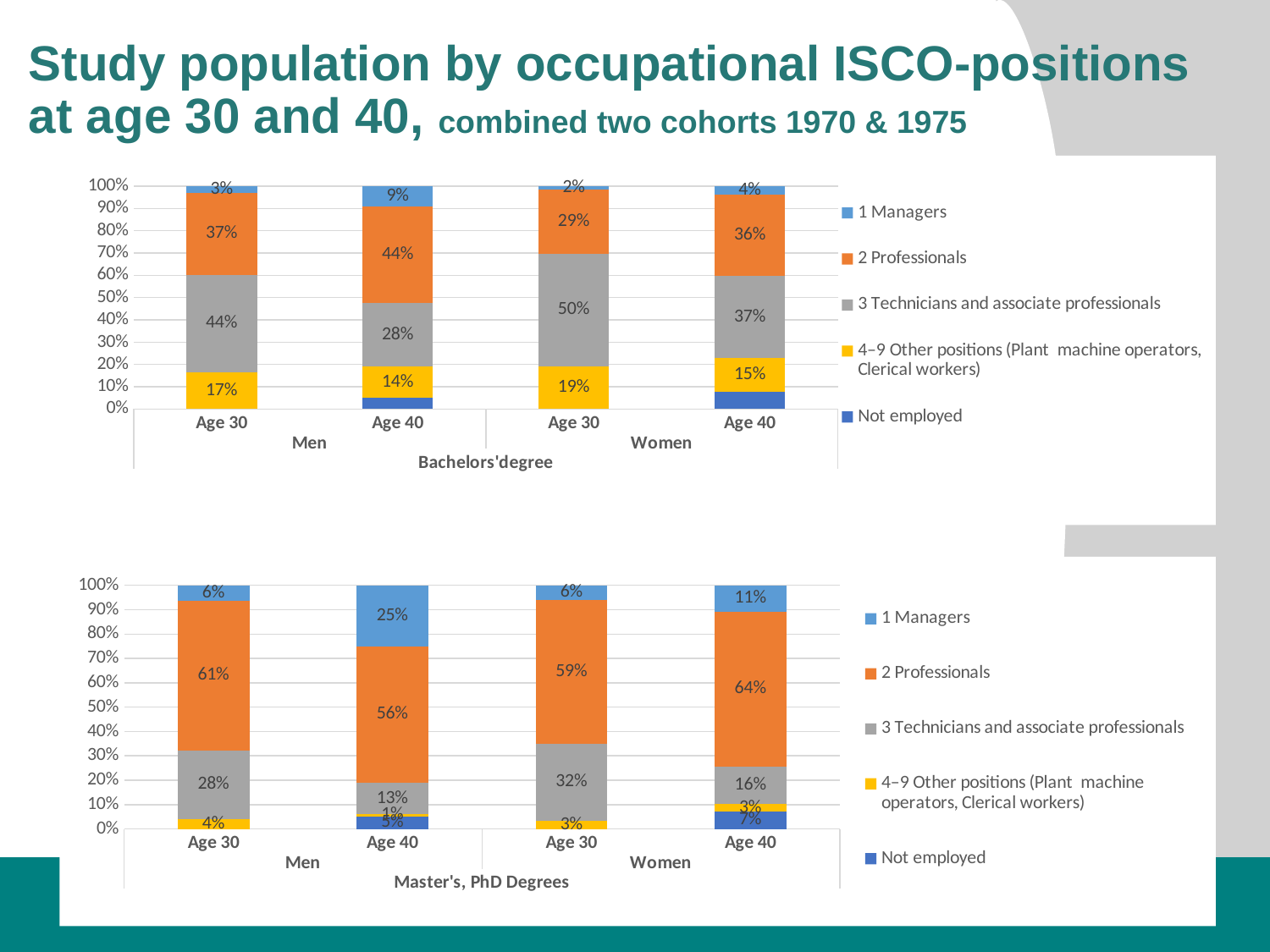
In the Bachelors'degree chart, what percentage of women at age 30 are Professionals? 29% In the Master's, PhD Degrees chart, what percentage of men at age 40 are Managers? 25% What type of chart is the Bachelors'degree chart? Stacked bar chart In the Bachelors'degree chart, which of the four bars has the highest share of Technicians and associate professionals? Women Age 30 How many bars are plotted in the Master's, PhD Degrees chart? 4 In the Bachelors'degree chart, what is the difference between the Professionals share for men at age 40 and men at age 30? 7% In the Master's, PhD Degrees chart, what percentage of women at age 40 are Professionals? 64% In the Master's, PhD Degrees chart, is the Professionals share for men at age 30 larger or smaller than for women at age 30? larger In the Master's, PhD Degrees chart, which bar has the lowest share of Technicians and associate professionals? Men Age 40 In the Bachelors'degree chart, what percentage of men at age 40 are Managers? 9% How many series does the legend of the Bachelors'degree chart list? 5 In the Bachelors'degree chart, what percentage of men at age 30 are in Technicians and associate professionals positions? 44%